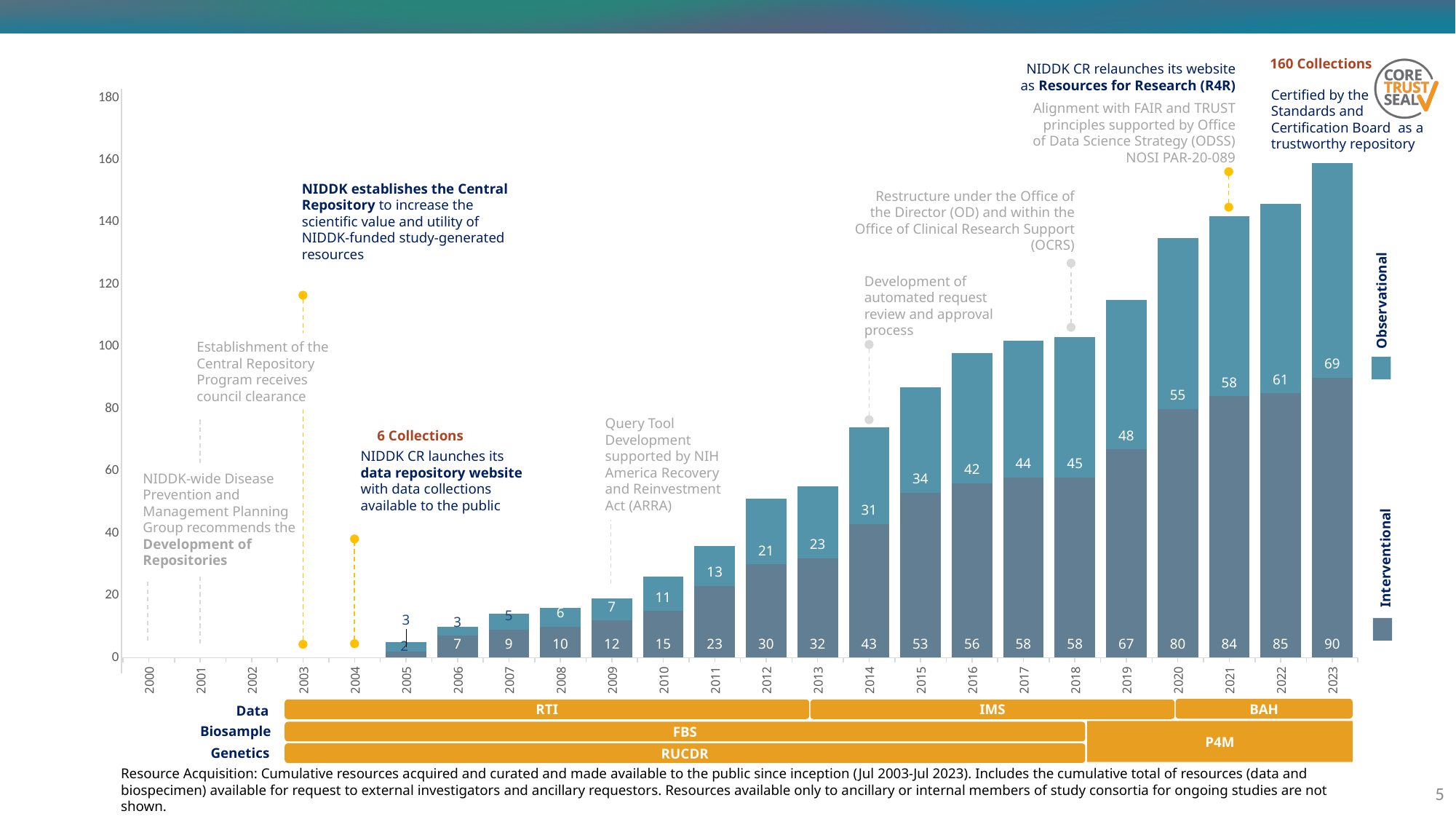
Is the total height of the 2019 stacked bar greater or less than 100? greater What is the difference between the Interventional values for 2020 and 2019? 13 What is the total of the stacked bar for 2020? 135 What is the Interventional value for 2023? 90 Which is larger, the Observational value for 2012 or the Observational value for 2011? 2012 What is the Interventional value for 2014? 43 Do the Interventional values rise or fall from 2005 to 2023? Rise What is the Observational value for 2016? 42 Which year has the lowest Interventional value among the years with data labels? 2005 How many series does the legend list? 2 What kind of chart is shown on the slide? Stacked bar chart Which year has the highest Observational value? 2023